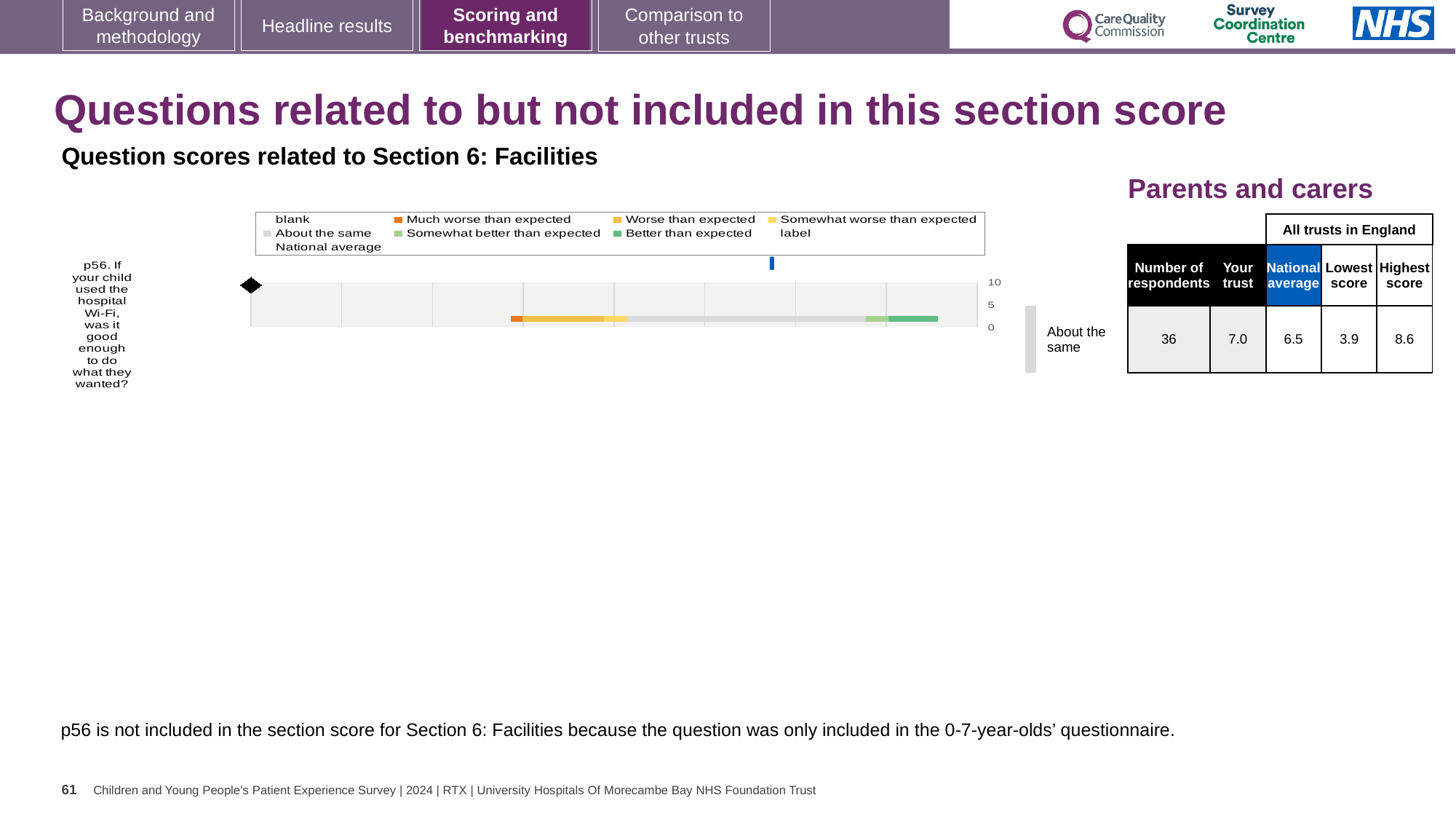
What is the 'Your trust' score for p56 (hospital Wi-Fi)? 7.0 What is the highest score among all trusts in England for p56? 8.6 How many respondents answered p56? 36 What type of chart is used to show the p56 question score? Bar chart Is the trust's score for p56 greater or less than 5? greater What is the national average score for p56? 6.5 What is the difference between the highest and lowest trust scores for p56? 4.7 Which benchmark category is the trust's p56 result placed in? About the same How many survey questions are plotted in the chart? 1 What is the lowest score among all trusts in England for p56? 3.9 Which is higher for p56: the trust's score or the national average? Your trust By how much does the trust's score for p56 exceed the national average? 0.5